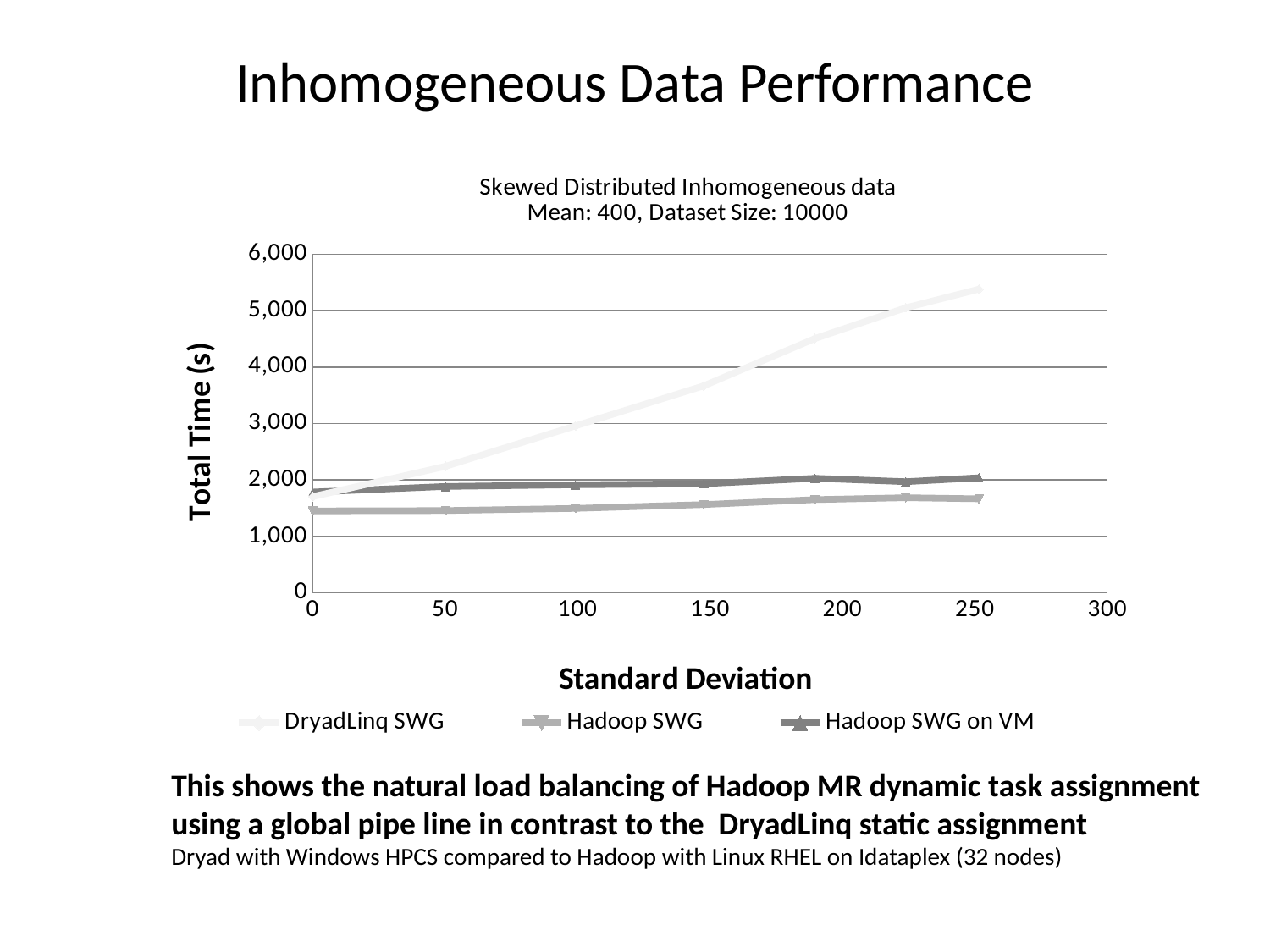
Which series has the lowest total time at a standard deviation of 250? Hadoop SWG At a standard deviation of 250, which is larger: Hadoop SWG on VM or Hadoop SWG? Hadoop SWG on VM How many series does the legend list? 3 Is the value for Hadoop SWG at a standard deviation of 250 greater or less than 2,000? less Is the value for Hadoop SWG on VM at a standard deviation of 250 greater or less than 3,000? less Is the value for DryadLinq SWG at a standard deviation of 150 greater or less than 3,000? greater What is the label of the y axis of the chart? Total Time (s) Does the total time for DryadLinq SWG rise or fall as the standard deviation increases? Rise Which series has the highest total time at a standard deviation of 250? DryadLinq SWG What kind of chart is shown on the slide? Line chart At a standard deviation of 250, which is larger: DryadLinq SWG or Hadoop SWG? DryadLinq SWG